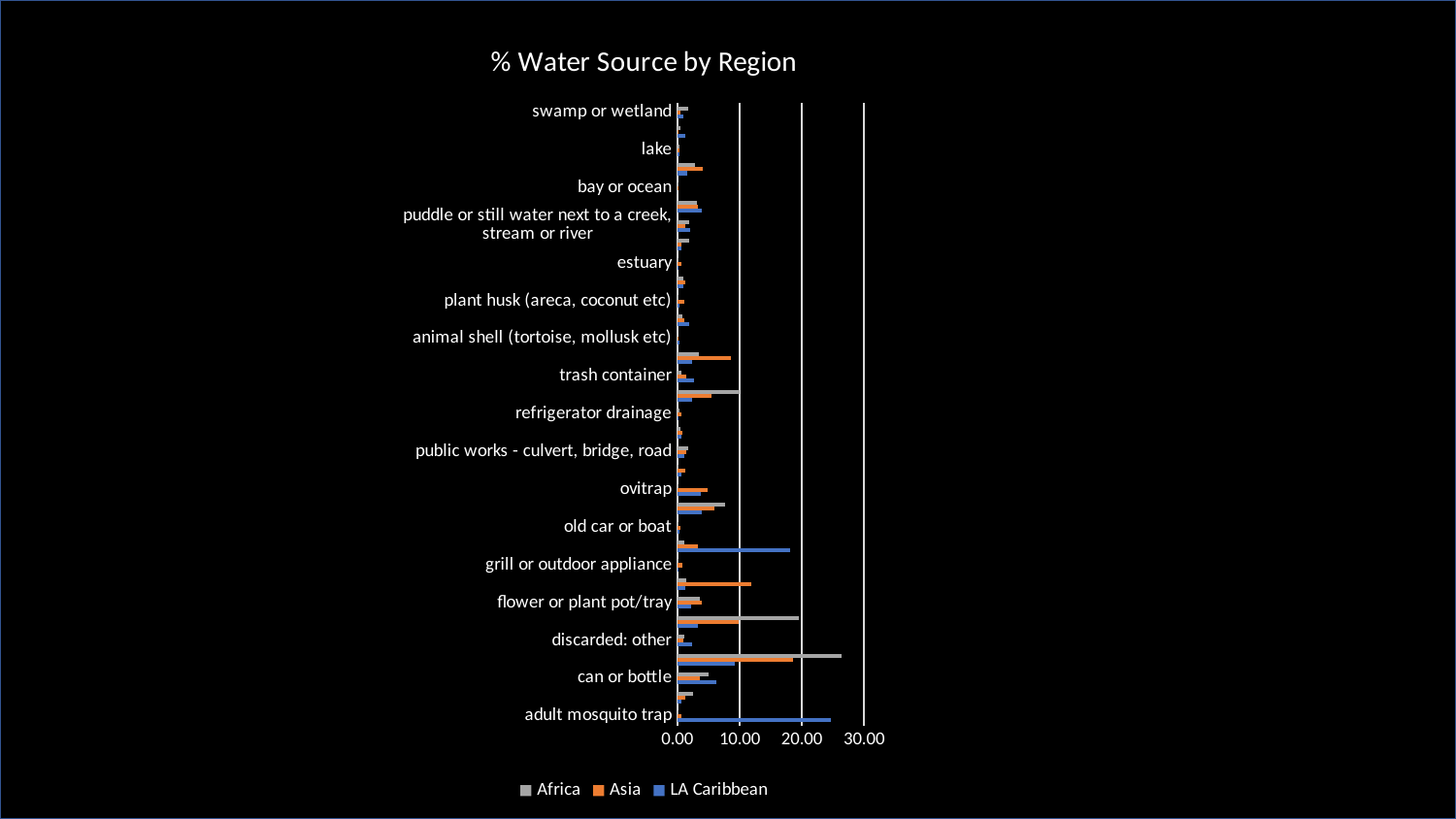
Is the Africa value for adult mosquito trap greater or less than 10? less Is the Africa value for swamp or wetland greater or less than 10? less Is the LA Caribbean value for estuary greater or less than 10? less What kind of chart is shown on the slide? bar chart For adult mosquito trap, which is larger: the LA Caribbean value or the Asia value? LA Caribbean How many series does the legend list? 3 What is the title of the chart? % Water Source by Region Which region has the highest value for adult mosquito trap? LA Caribbean Which series is shown in orange in the legend? Asia